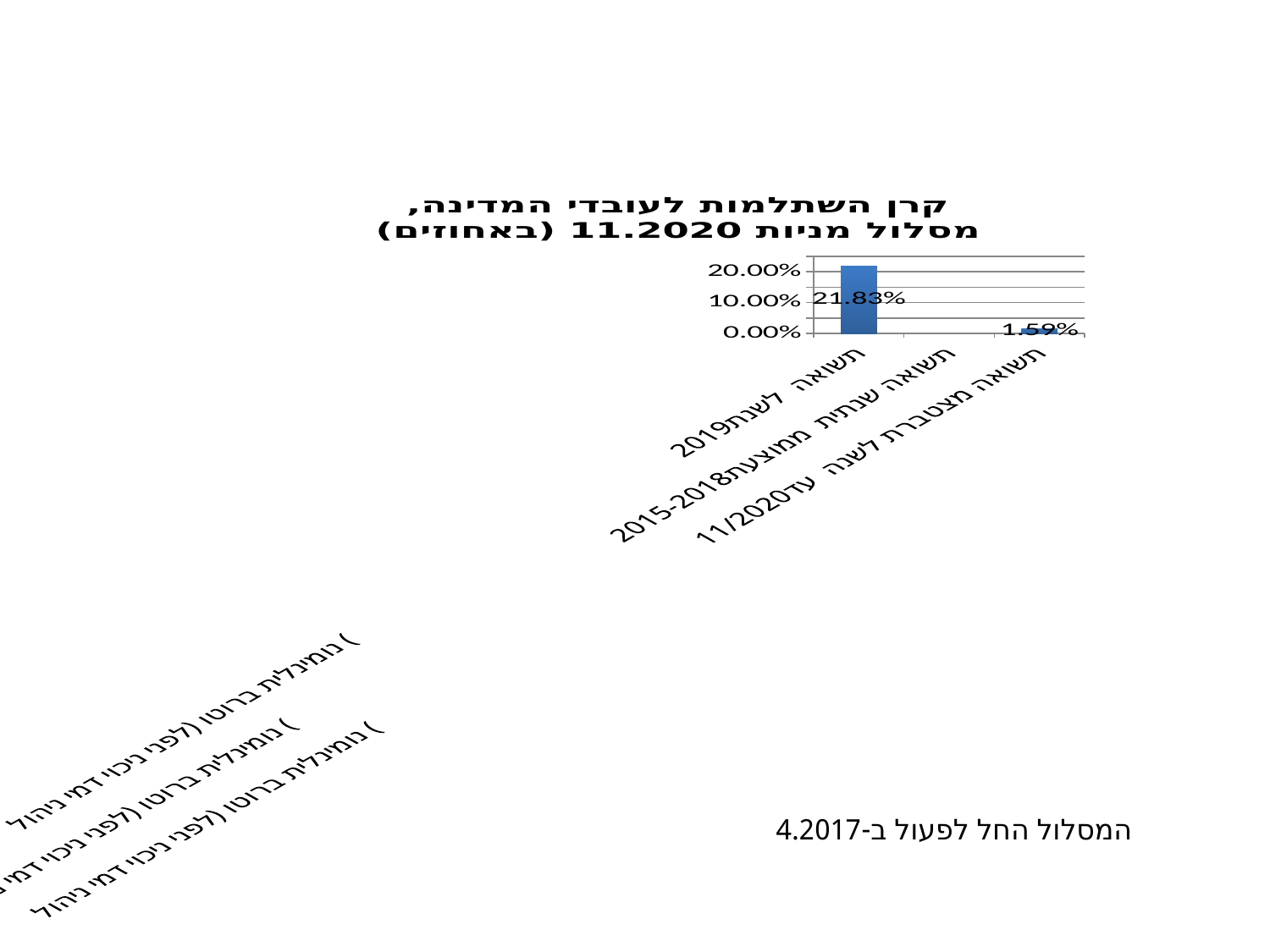
What kind of chart is shown on the slide? bar chart Which category has the highest value? תשואה לשנת 2019 What is the value for תשואה מצטברת לשנה עד 11/2020? 1.59% How many categories are shown on the x axis of the chart? 3 Is the value for תשואה מצטברת לשנה עד 11/2020 greater or less than 10.00%? less Is the value for תשואה לשנת 2019 greater or less than 20.00%? greater What is the value for תשואה לשנת 2019? 21.83% What is the title of the chart? קרן השתלמות לעובדי המדינה, מסלול מניות 11.2020 (באחוזים) What is the difference between the value for תשואה לשנת 2019 and the value for תשואה מצטברת לשנה עד 11/2020? 20.24% Which is larger: the value for תשואה לשנת 2019 or the value for תשואה מצטברת לשנה עד 11/2020? תשואה לשנת 2019 What is the highest tick value shown on the y axis of the chart? 20.00%